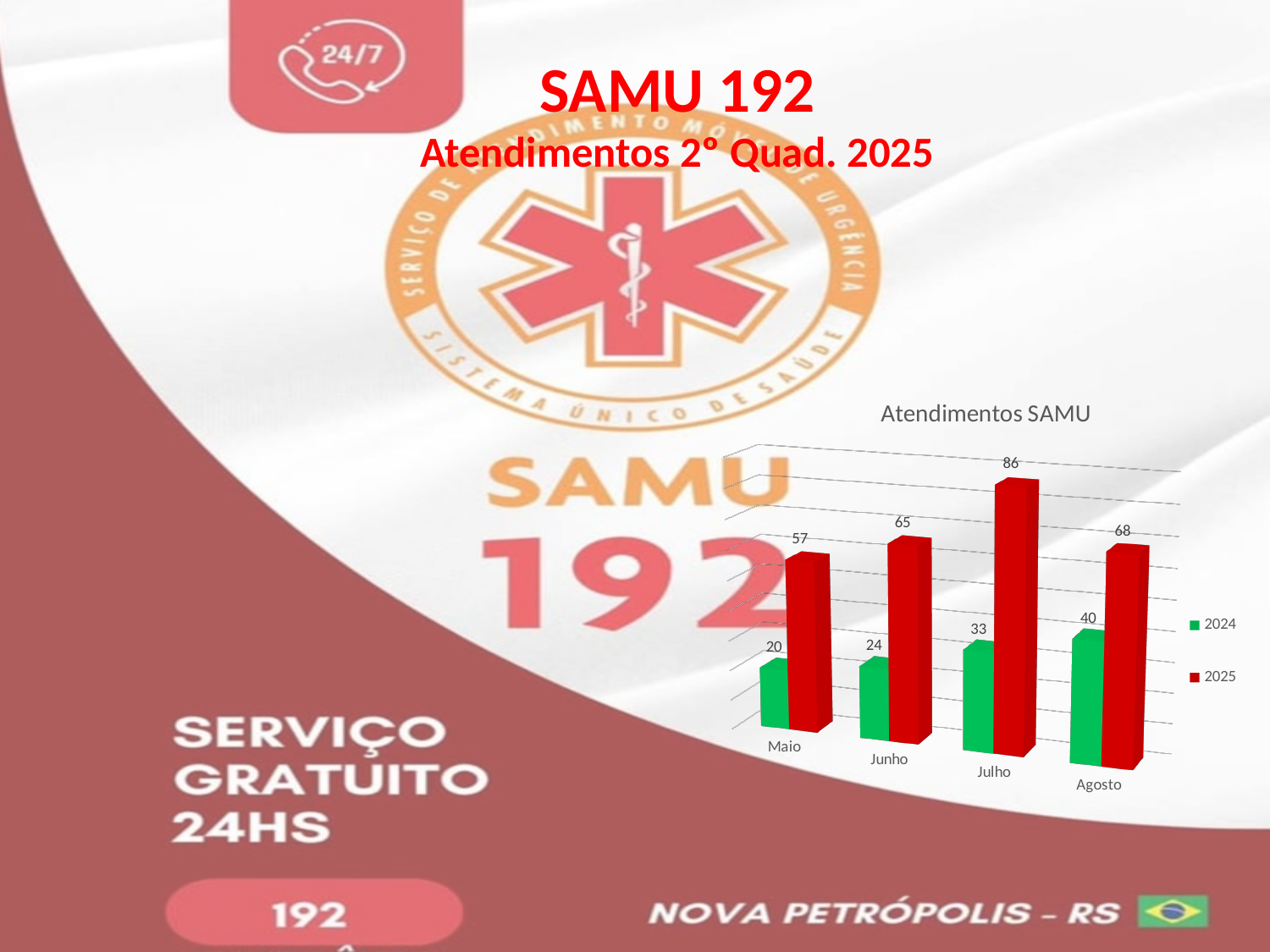
Which month has the lowest value for the 2024 series? Maio What is the value for 2024 in Junho? 24 Which month has the highest value for the 2025 series? Julho Do the 2024 values rise or fall from Maio to Agosto? Rise How many months are shown on the x axis of the chart? 4 What is the value for 2025 in Agosto? 68 What is the value for 2024 in Maio? 20 How many series does the chart legend list? 2 What kind of chart is shown on the slide? Bar chart Which is larger in Agosto, the 2024 value or the 2025 value? 2025 What is the difference between the 2025 and 2024 values in Julho? 53 What is the value for 2025 in Julho? 86